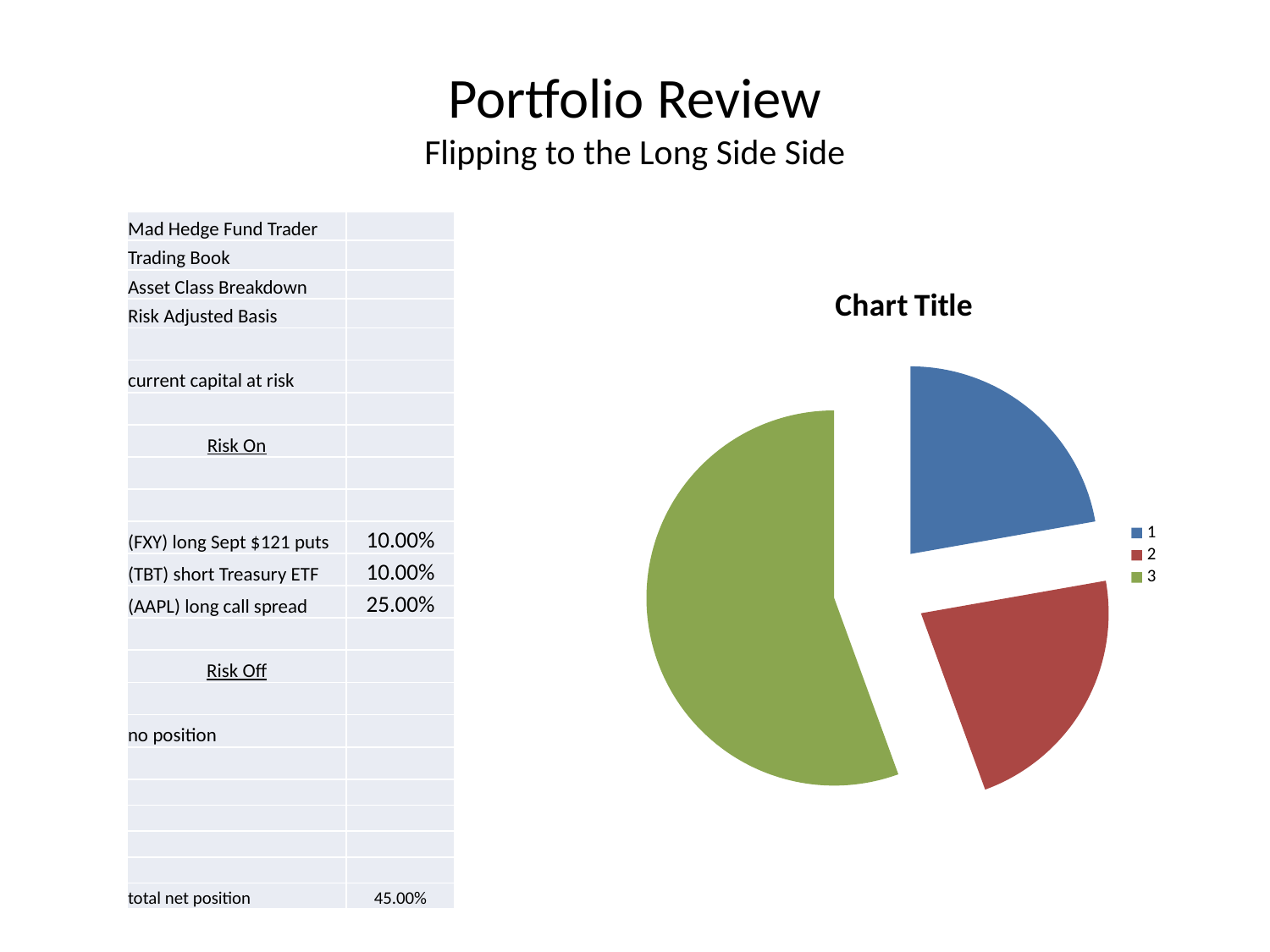
Which is larger in the pie chart, slice 2 or slice 3? 3 What is the title of the chart? Chart Title Does slice 3 take up more or less than half of the pie chart? more Which slice of the pie chart is the largest? 3 Which is larger in the pie chart, slice 3 or slice 1? 3 What colour is slice 3 in the pie chart? green How many slices does the pie chart have? 3 What kind of chart is shown on the slide? pie chart How many entries does the chart legend list? 3